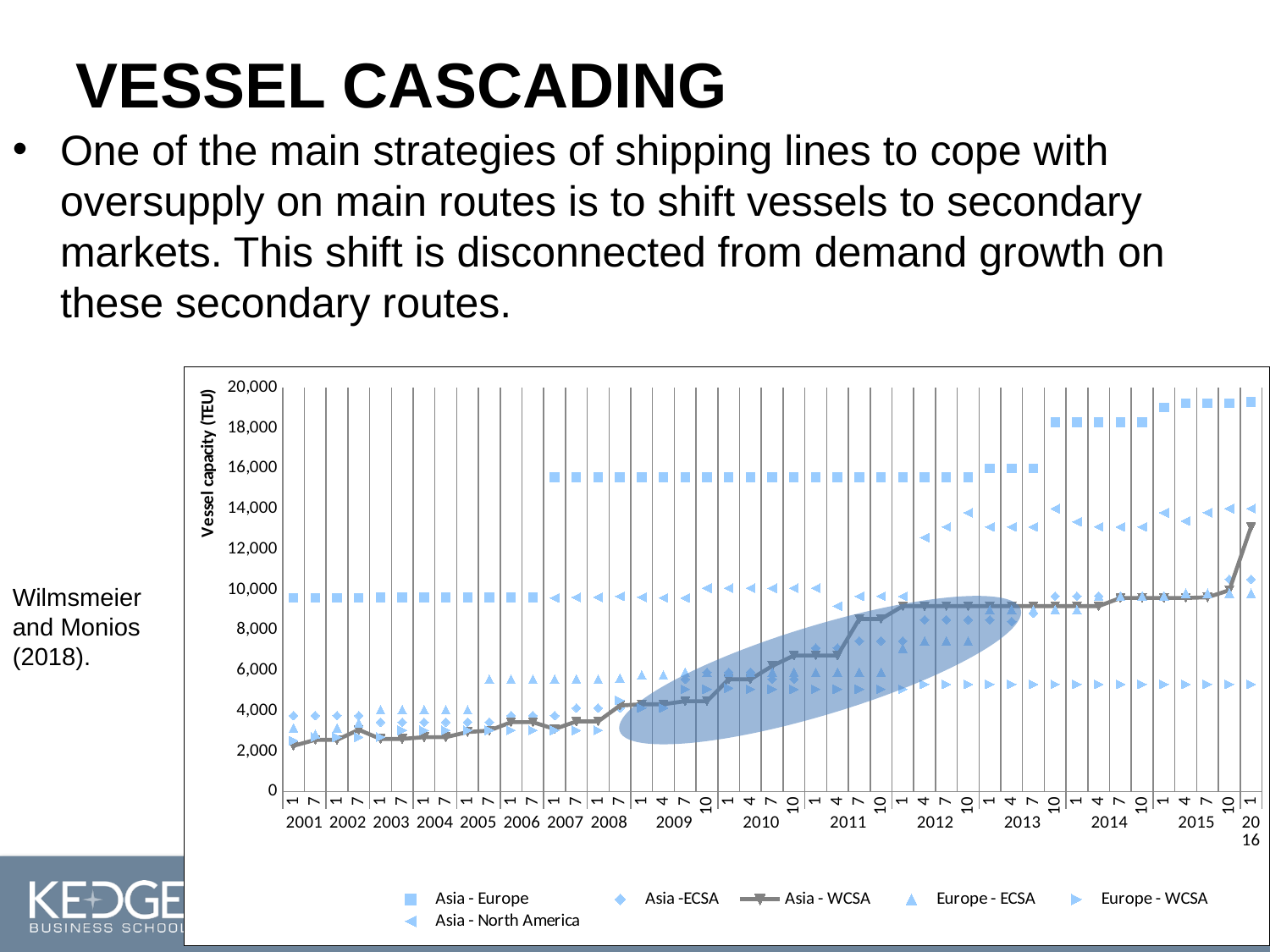
Is the value for Europe - WCSA in 2015 greater or less than 4,000? greater Is the value for Asia - Europe in 2016 greater or less than 18,000? greater Does the Asia - WCSA line rise or fall from 2001 to 2016? rise How many series does the chart legend list? 6 Is the value for Asia - WCSA at the start of 2001 greater or less than 4,000? less What is the highest value shown on the vertical axis of the chart? 20,000 Does the Asia - Europe series rise or fall from 2001 to 2016? rise In 2015, which is larger: the value for Asia - Europe or the value for Europe - WCSA? Asia - Europe Which series has the highest vessel capacity in 2016? Asia - Europe What is the label of the vertical axis of the chart? Vessel capacity (TEU) What kind of chart is shown on the slide? Scatter chart with a line series